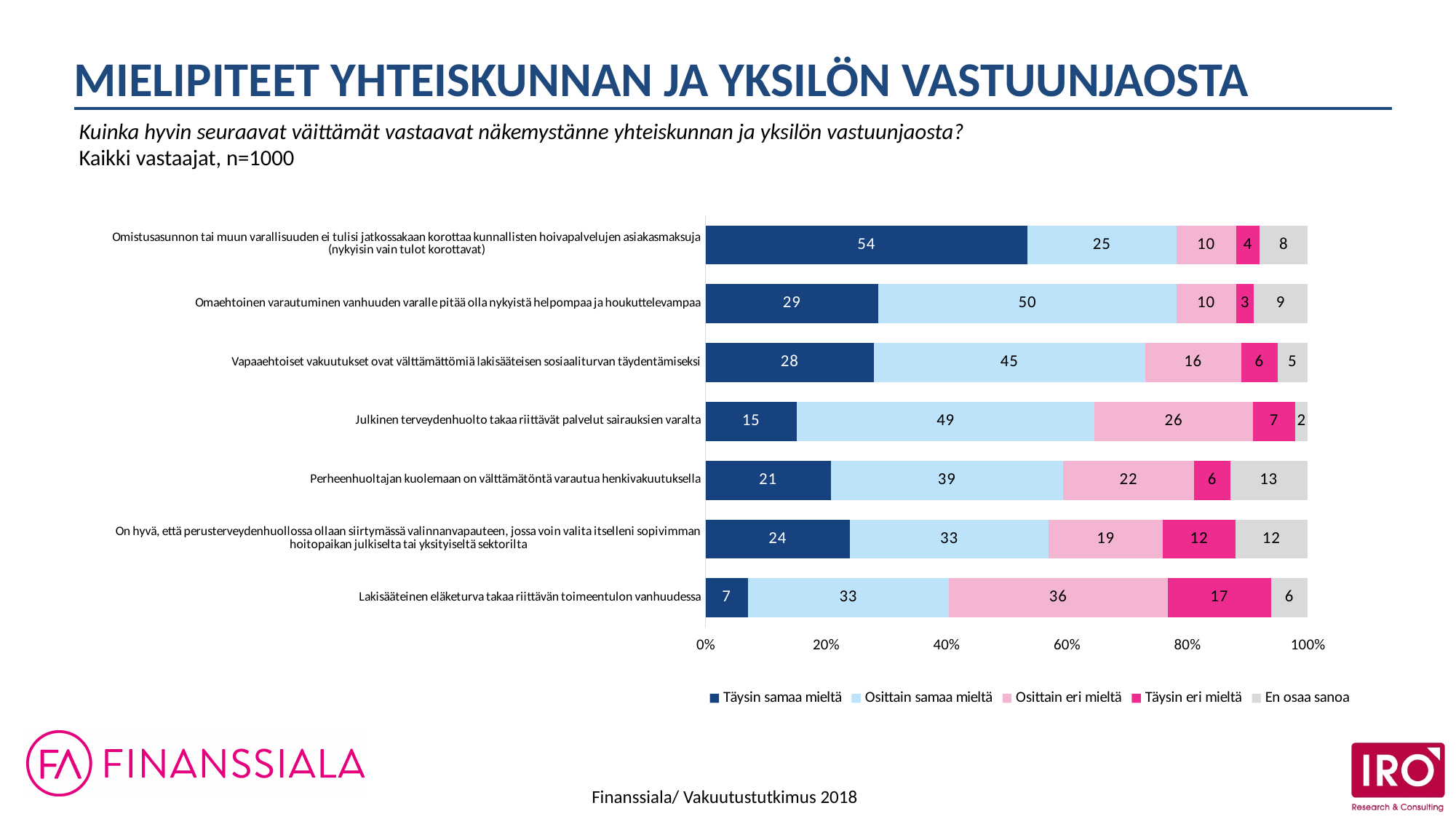
What is the 'En osaa sanoa' value for 'Perheenhuoltajan kuolemaan on välttämätöntä varautua henkivakuutuksella'? 13 How many statements (categories) are plotted in the chart? 7 Which legend entry is shown in dark blue? Täysin samaa mieltä Which is larger: the 'Täysin samaa mieltä' value for 'Vapaaehtoiset vakuutukset ovat välttämättömiä lakisääteisen sosiaaliturvan täydentämiseksi' or for 'Perheenhuoltajan kuolemaan on välttämätöntä varautua henkivakuutuksella'? Vapaaehtoiset vakuutukset ovat välttämättömiä lakisääteisen sosiaaliturvan täydentämiseksi Which statement has the lowest 'Täysin samaa mieltä' value? Lakisääteinen eläketurva takaa riittävän toimeentulon vanhuudessa Which statement has the highest 'Täysin samaa mieltä' value? Omistusasunnon tai muun varallisuuden ei tulisi jatkossakaan korottaa kunnallisten hoivapalvelujen asiakasmaksuja What kind of chart is shown on the slide? Stacked bar chart What is the 'Täysin samaa mieltä' value for 'Lakisääteinen eläketurva takaa riittävän toimeentulon vanhuudessa'? 7 How many series does the legend list? 5 What is the difference between the 'Osittain eri mieltä' values for 'Lakisääteinen eläketurva takaa riittävän toimeentulon vanhuudessa' and 'Julkinen terveydenhuolto takaa riittävät palvelut sairauksien varalta'? 10 What is the 'Osittain samaa mieltä' value for 'Omaehtoinen varautuminen vanhuuden varalle pitää olla nykyistä helpompaa ja houkuttelevampaa'? 50 Which statement has the highest 'Täysin eri mieltä' value? Lakisääteinen eläketurva takaa riittävän toimeentulon vanhuudessa